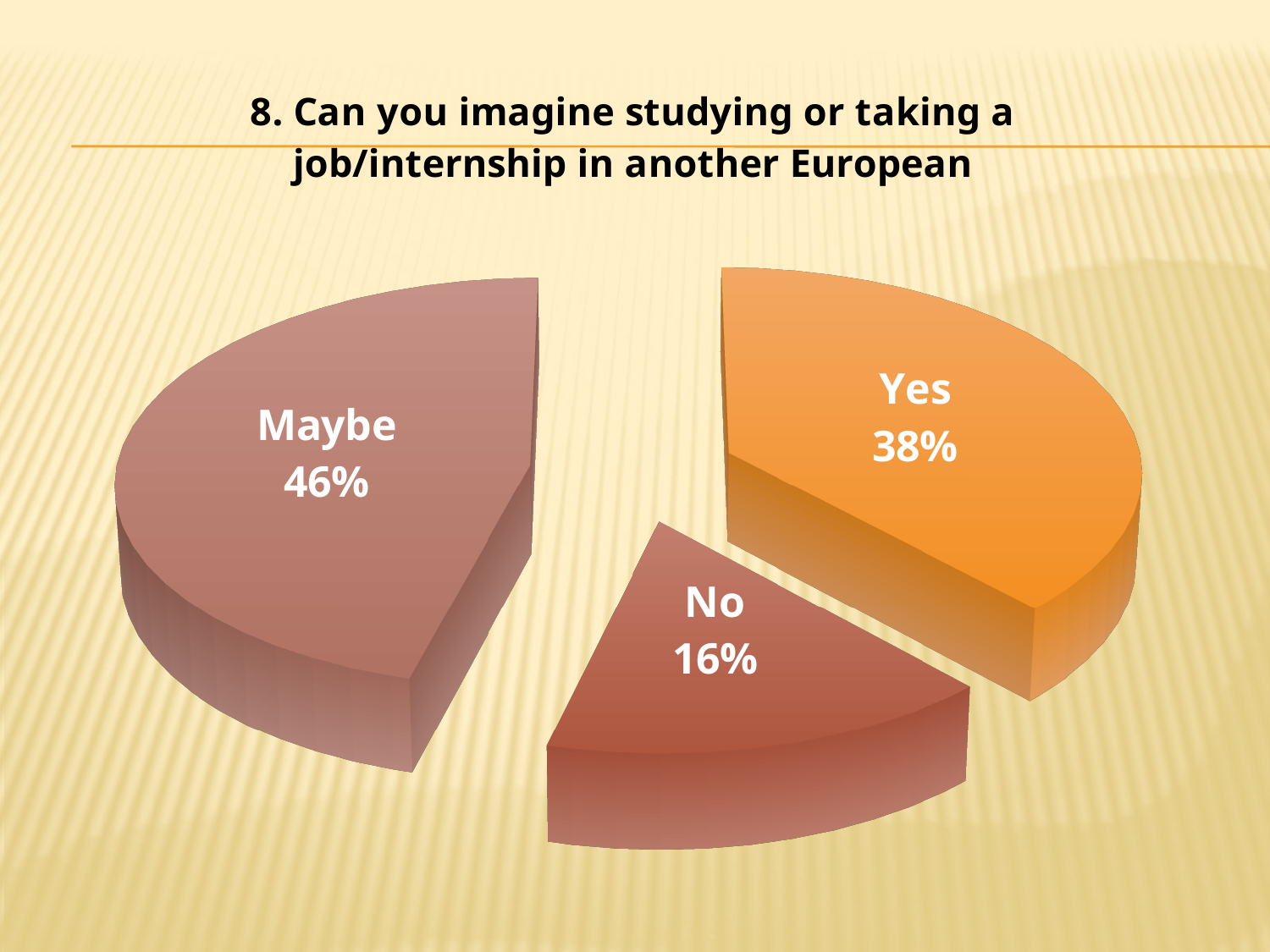
What is the difference in percentage points between "Maybe" and "Yes"? 8 What is the difference in percentage points between "Yes" and "No"? 22 Which answer has the largest share of the pie? Maybe What percentage of respondents answered "Yes"? 38% Which answer has the smallest share of the pie? No What colour is the "Yes" slice? Orange What share of the pie does the "No" slice represent? 16% What percentage of respondents answered "No"? 16% How many slices does the pie chart have? 3 Which is larger, the share for "Yes" or the share for "No"? Yes What kind of chart is shown on the slide? Pie chart What percentage of respondents answered "Maybe"? 46%